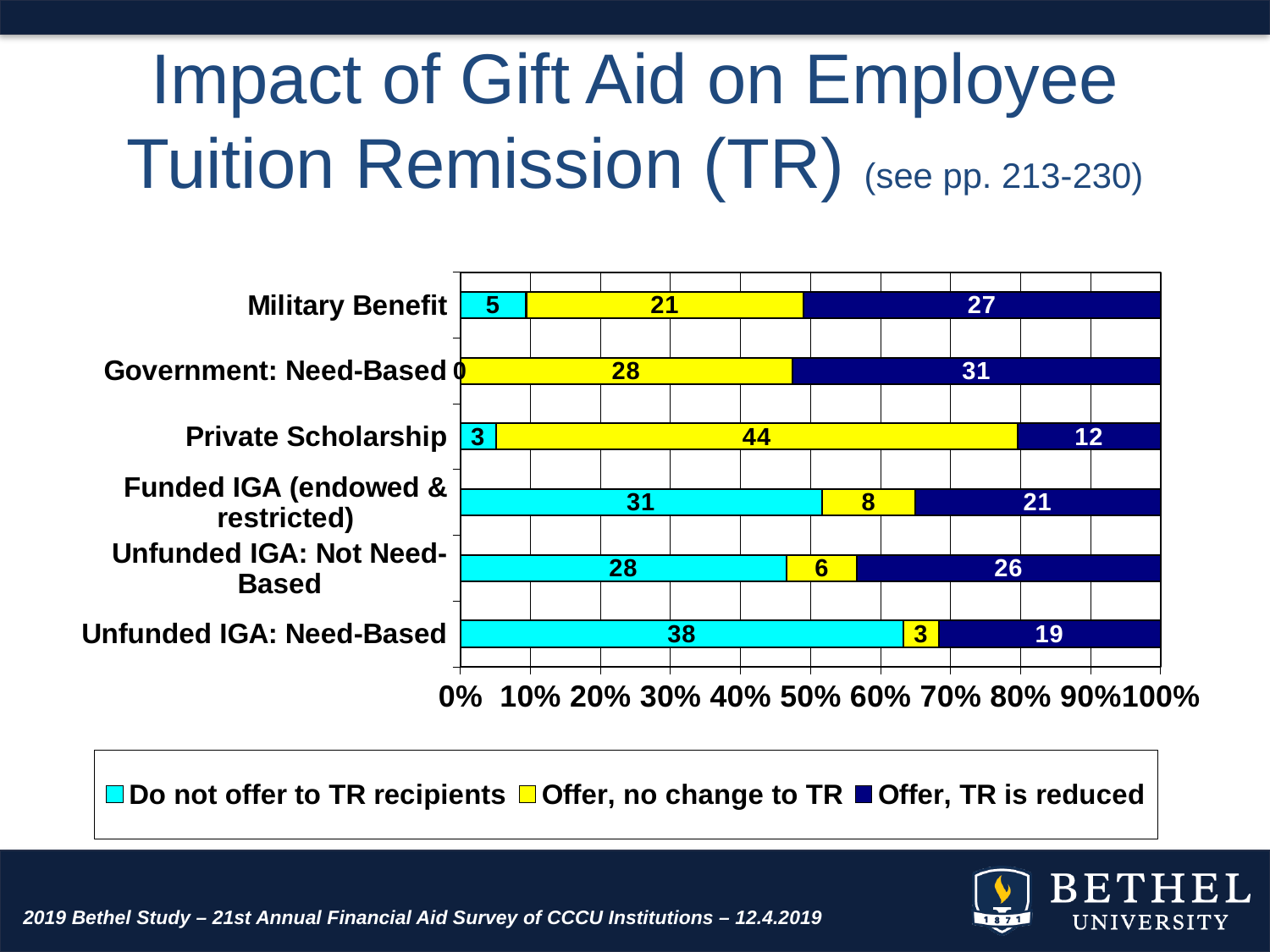
What is the difference between the "Offer, TR is reduced" values for Government: Need-Based and Private Scholarship? 19 Which category has the lowest value for "Do not offer to TR recipients"? Government: Need-Based What is the value for "Offer, no change to TR" for Private Scholarship? 44 What is the total of the three values in the Military Benefit bar? 53 What is the value for "Offer, TR is reduced" for Government: Need-Based? 31 Which category has the highest value for "Offer, no change to TR"? Private Scholarship What is the value for "Do not offer to TR recipients" for Unfunded IGA: Need-Based? 38 How many series does the legend list? 3 Which is larger: the "Do not offer to TR recipients" value for Funded IGA (endowed & restricted) or for Unfunded IGA: Not Need-Based? Funded IGA (endowed & restricted) What kind of chart is shown on the slide? Stacked bar chart How many categories are plotted on the chart? 6 Which legend entry is shown in yellow? Offer, no change to TR